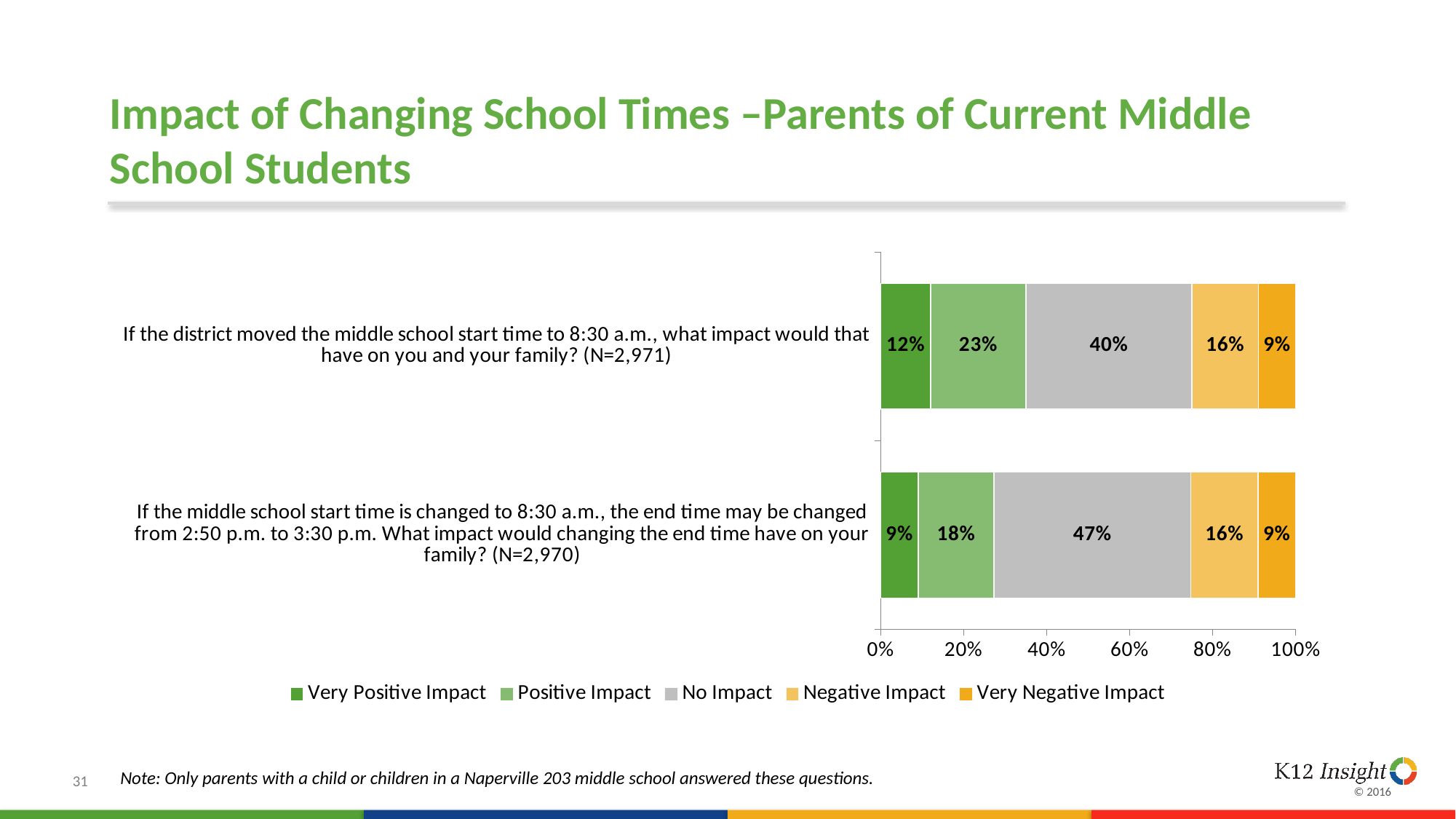
Which response category has the largest share for the question about changing the end time to 3:30 p.m.? No Impact Which legend entry is shown in grey? No Impact How many series does the legend list? 5 What is the difference between the No Impact percentages for the end-time question and the start-time question? 7 percentage points What percentage of parents said changing the end time would have a Positive Impact? 18% What percentage of parents said changing the end time from 2:50 p.m. to 3:30 p.m. would have a Very Positive Impact? 9% What kind of chart is shown on the slide? Stacked bar chart What is the combined percentage of Very Positive Impact and Positive Impact for the start-time question? 35% How many survey questions (bars) are shown in the chart? 2 What percentage of parents said moving the start time to 8:30 a.m. would have a Negative Impact? 16% Which question has a higher Very Positive Impact percentage: the start-time question or the end-time question? The start-time question What percentage of parents said moving the middle school start time to 8:30 a.m. would have No Impact on their family? 40%